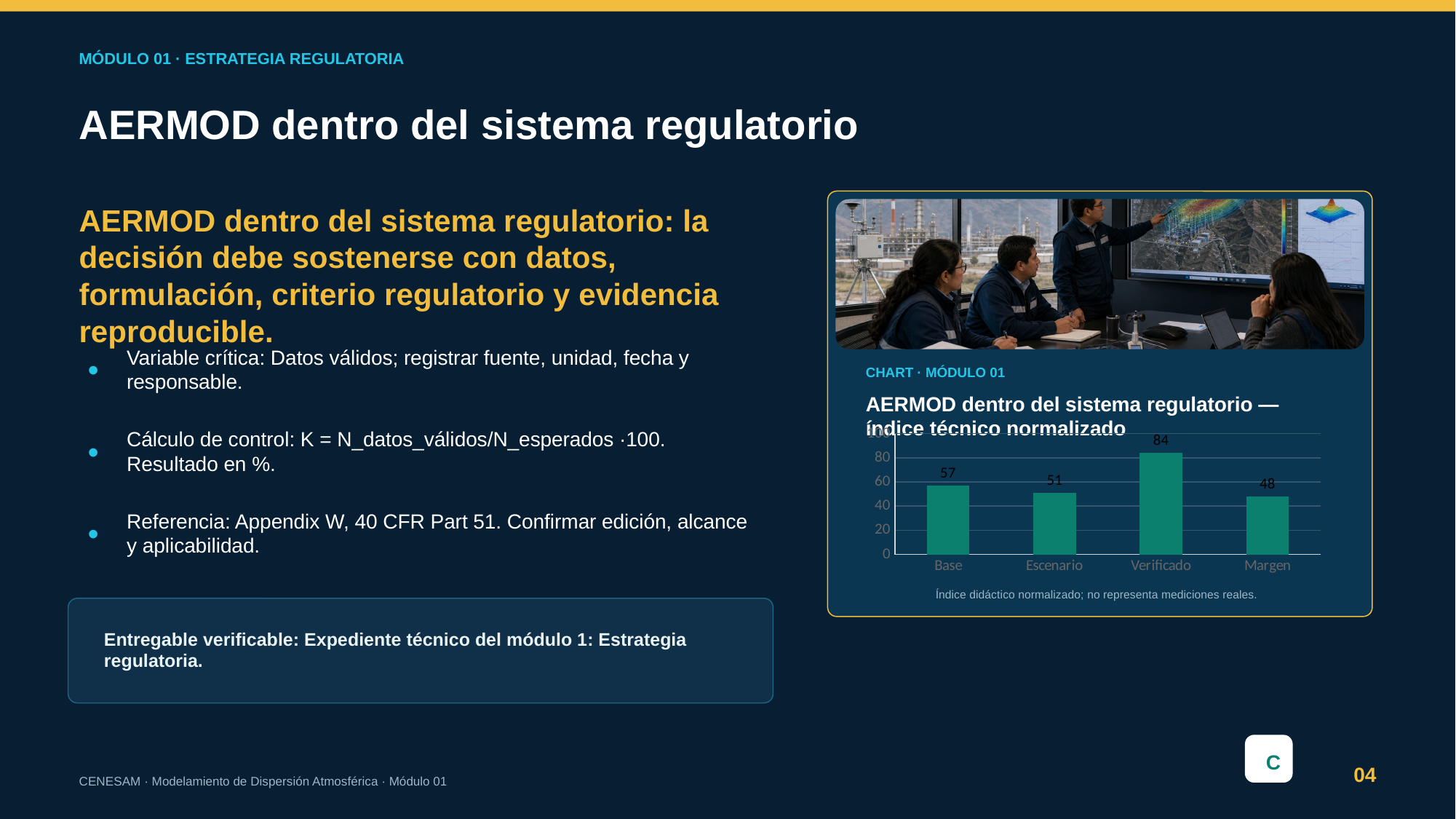
How many categories are shown on the x axis? 4 What is the difference between the values for Verificado and Margen? 36 What is the value for Escenario? 51 Which category has the highest value? Verificado Which is larger, the value for Base or the value for Margen? Base What is the value for Margen? 48 Which category has the lowest value? Margen What kind of chart is shown on the slide? Bar chart What is the difference between the values for Base and Escenario? 6 What is the value for Base? 57 Is the value for Verificado greater or less than 80? greater What is the value for Verificado? 84